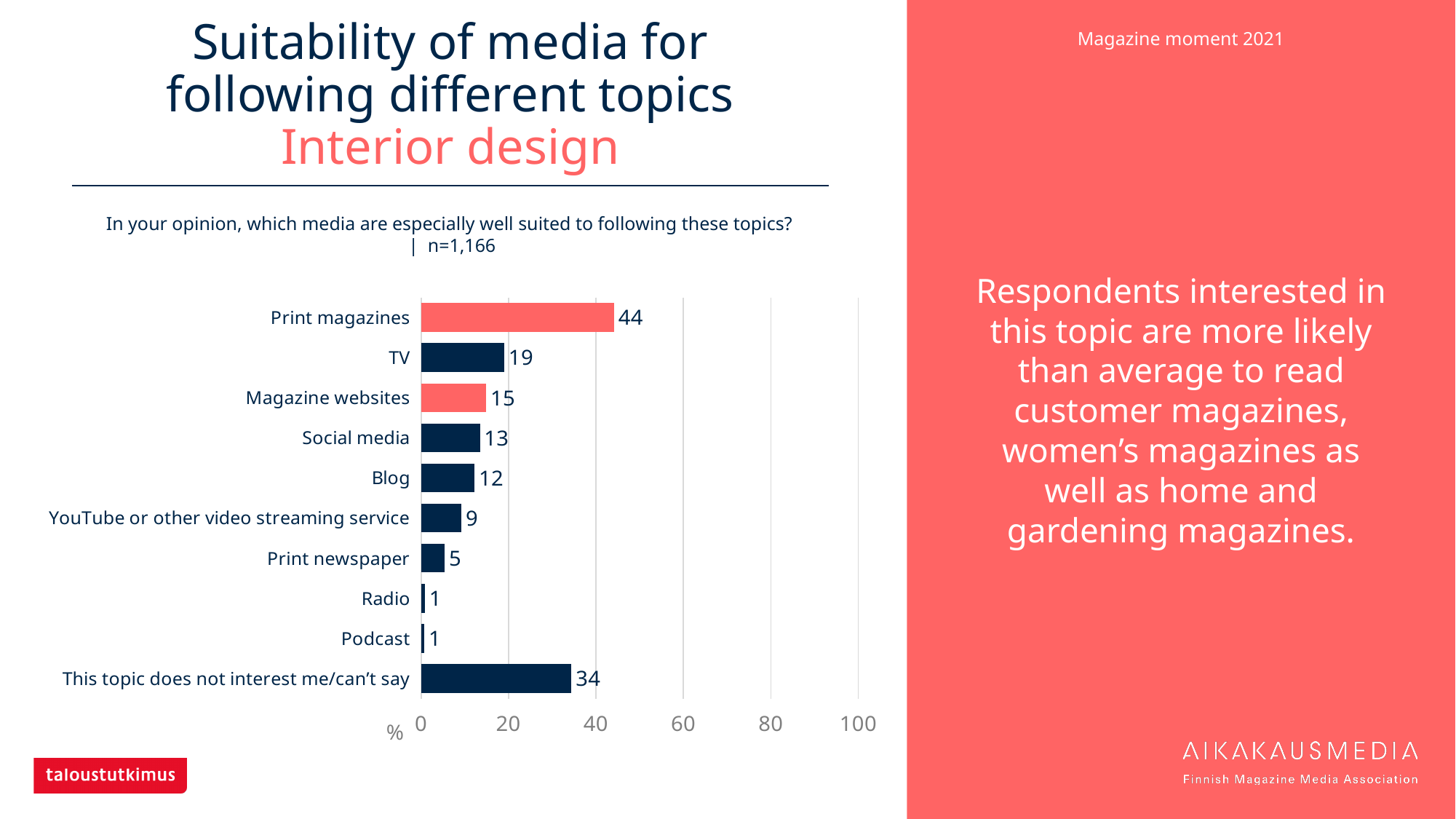
What is the value for YouTube or other video streaming service? 9 How many categories are shown in the chart? 10 Is the value for Print magazines greater or less than 40? greater Which category has the highest value? Print magazines What is the difference between the values for Print magazines and TV? 25 What is the value for 'This topic does not interest me/can't say'? 34 What is the value for Magazine websites? 15 What is the sample size (n) stated on the slide? n=1,166 What is the value for Print magazines? 44 Which is larger, the value for Social media or the value for Blog? Social media What is the value for TV? 19 What kind of chart is shown on the slide? Bar chart